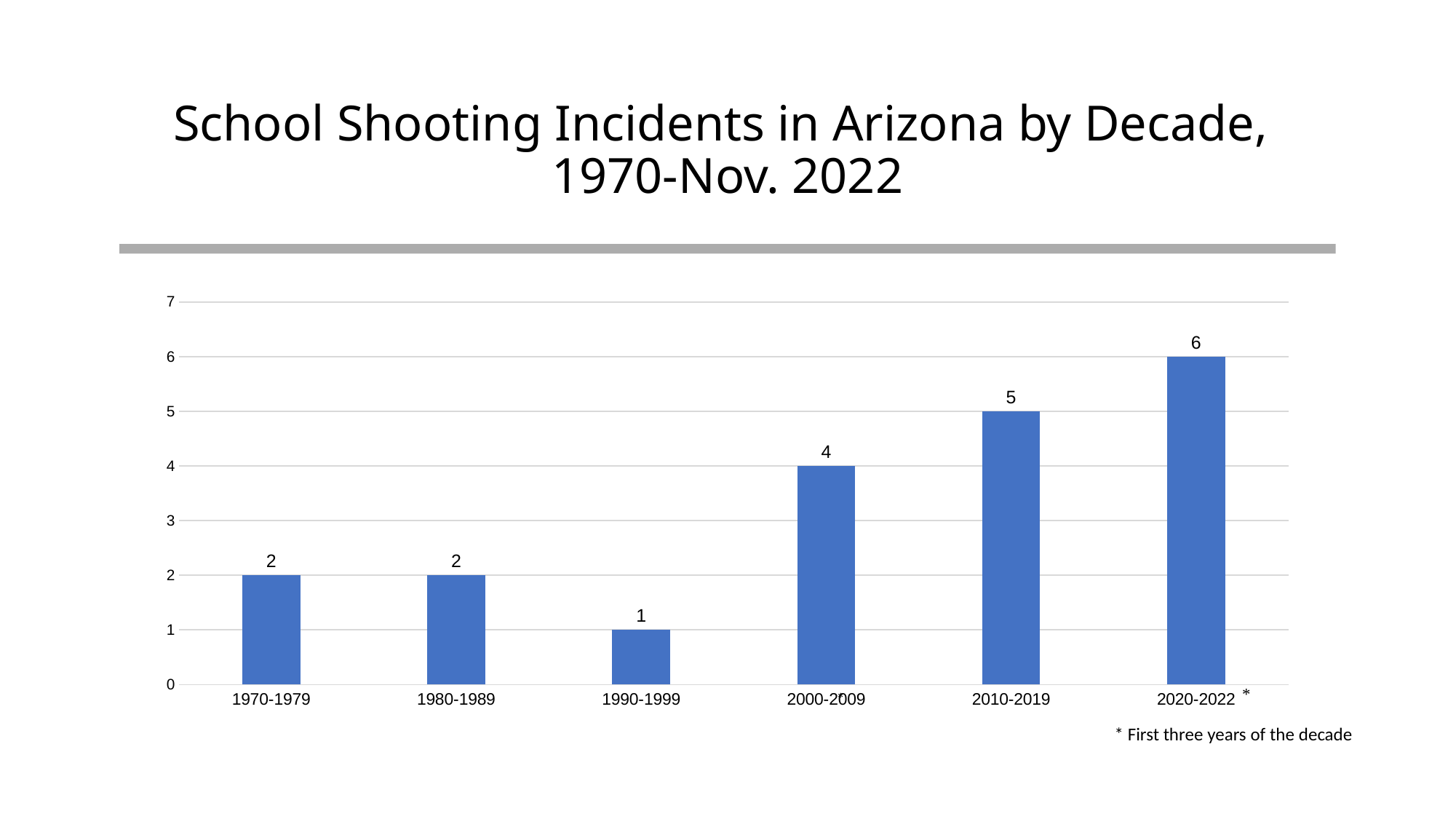
What is the difference between the values for 2010-2019 and 1980-1989? 3 What is the value for 2000-2009? 4 Which is larger, the value for 2000-2009 or the value for 2010-2019? 2010-2019 What does the asterisk next to 2020-2022 indicate, according to the footnote? First three years of the decade Which decade has the highest number of incidents? 2020-2022 What kind of chart is shown on the slide? bar chart What is the value for 1970-1979? 2 How many decade categories are shown on the x axis? 6 What is the value for 1990-1999? 1 What is the value for 2020-2022? 6 Which decade has the lowest number of incidents? 1990-1999 Is the value for 2020-2022 greater or less than 5? greater